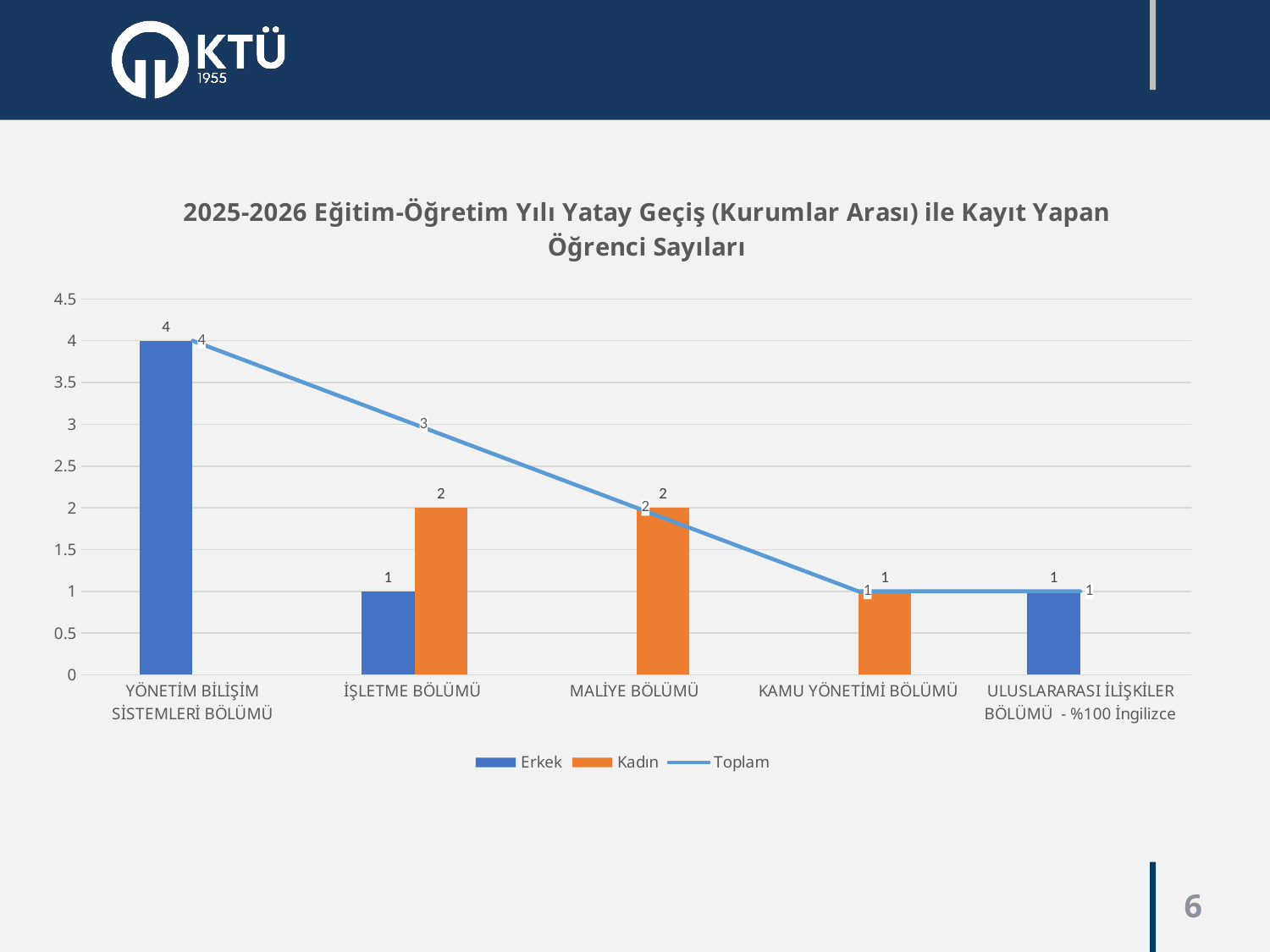
Which series is shown as a line rather than bars? Toplam Which is larger for İŞLETME BÖLÜMÜ, the Erkek value or the Kadın value? Kadın What is the Toplam value for İŞLETME BÖLÜMÜ? 3 Which department has the highest Erkek value? YÖNETİM BİLİŞİM SİSTEMLERİ BÖLÜMÜ What is the Kadın value for İŞLETME BÖLÜMÜ? 2 How many departments are shown on the x axis? 5 What is the Erkek value for YÖNETİM BİLİŞİM SİSTEMLERİ BÖLÜMÜ? 4 What is the Kadın value for KAMU YÖNETİMİ BÖLÜMÜ? 1 What is the difference between the Toplam value for YÖNETİM BİLİŞİM SİSTEMLERİ BÖLÜMÜ and the Toplam value for MALİYE BÖLÜMÜ? 2 How many series does the legend list? 3 Which department has the highest Toplam value? YÖNETİM BİLİŞİM SİSTEMLERİ BÖLÜMÜ Does the Toplam line rise or fall from left to right across the chart? fall